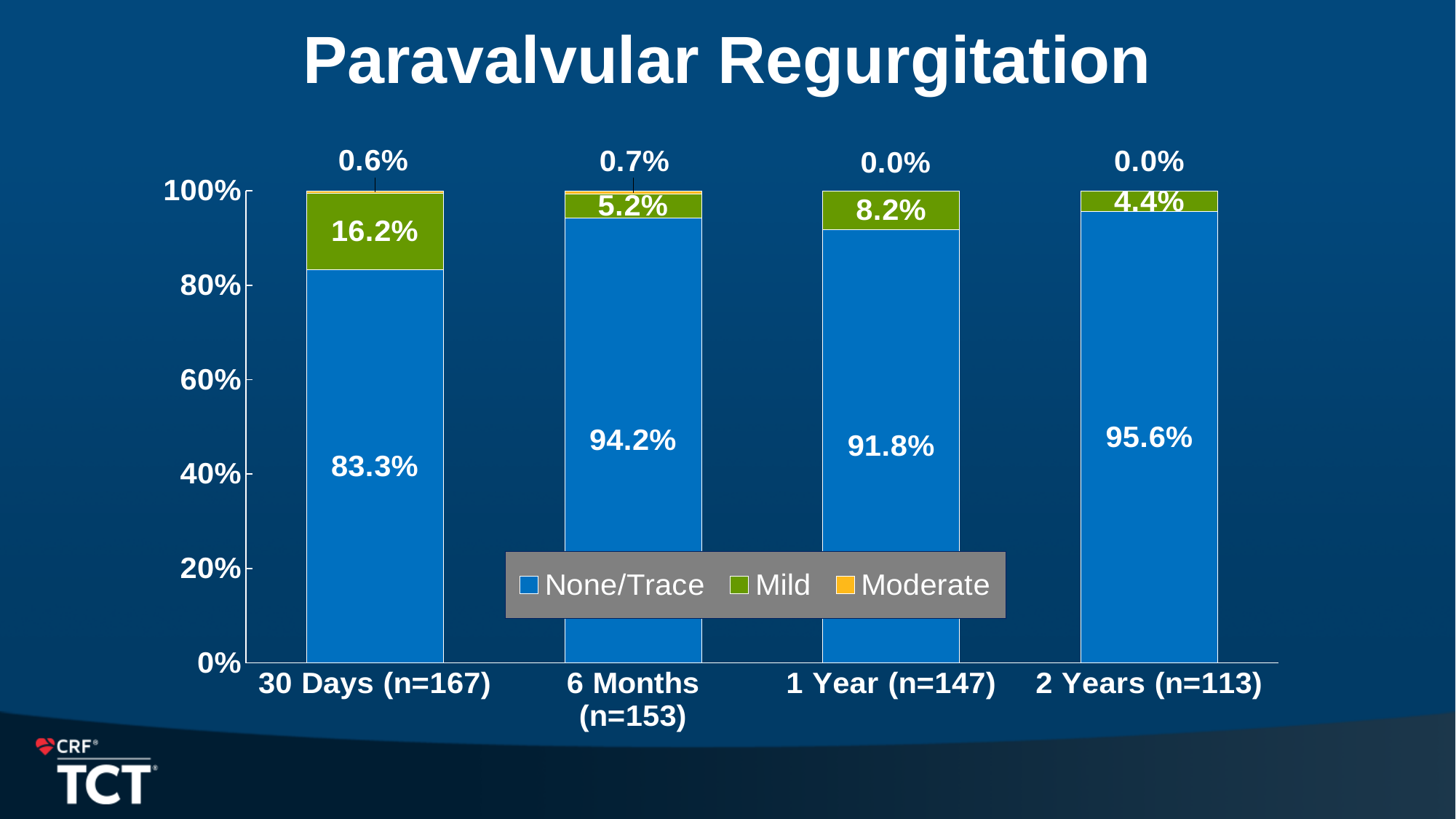
What is the None/Trace value at 2 Years (n=113)? 95.6% Is the None/Trace value at 30 Days (n=167) greater or less than 80%? greater What is the Moderate value at 6 Months (n=153)? 0.7% At which time point is the Mild value highest? 30 Days (n=167) What is the None/Trace value at 30 Days (n=167)? 83.3% How many time points are shown on the x axis? 4 Which is larger, the None/Trace value at 6 Months (n=153) or at 1 Year (n=147)? 6 Months (n=153) What is the difference between the Mild value at 30 Days (n=167) and at 6 Months (n=153)? 11.0% What kind of chart is shown on the slide? Stacked bar chart How many series does the legend list? 3 At which time point is the None/Trace value lowest? 30 Days (n=167) What is the Mild value at 1 Year (n=147)? 8.2%